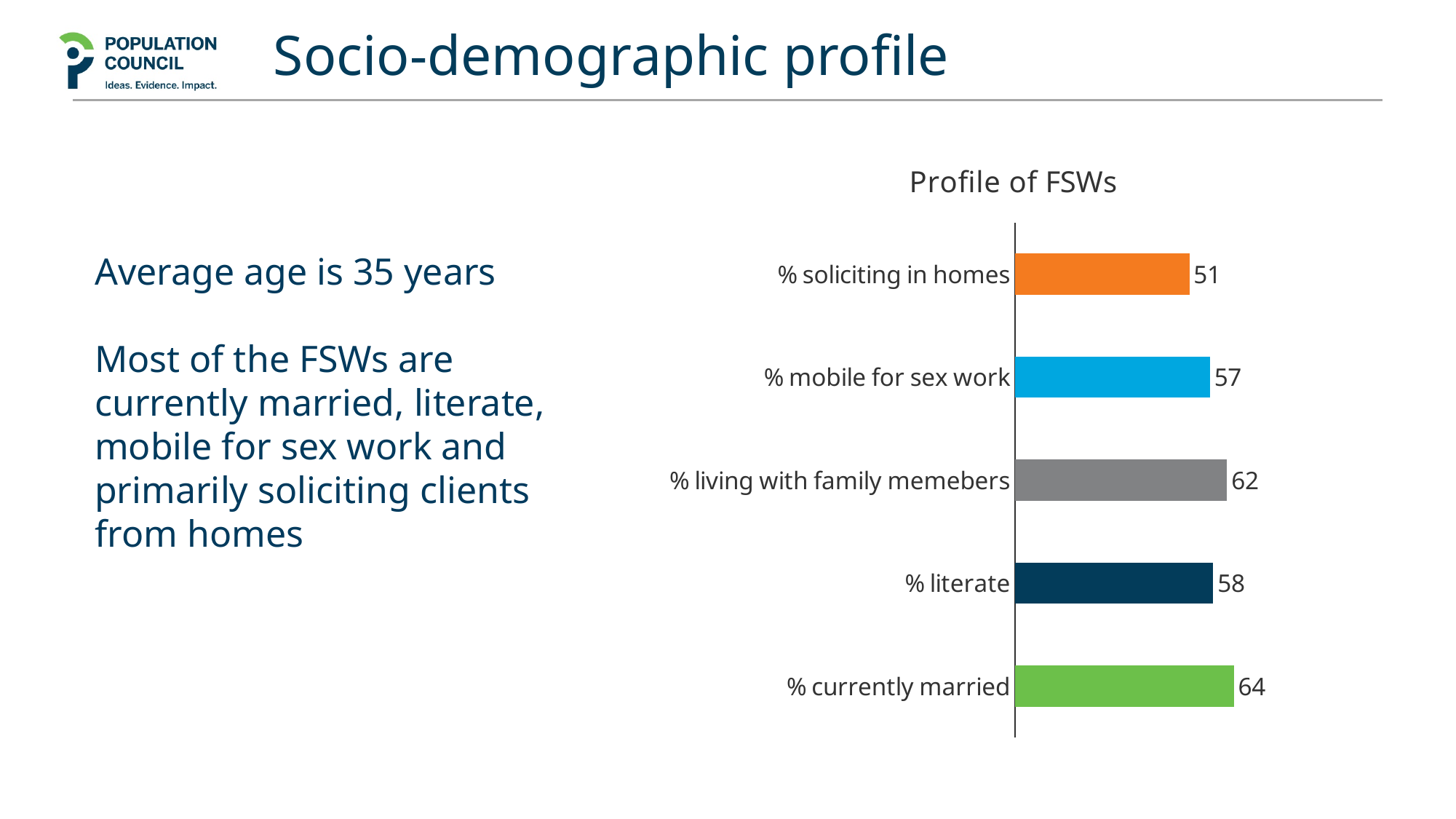
Which category has the lowest value? % soliciting in homes How many categories are shown in the chart? 5 What is the value for % living with family memebers? 62 What is the difference between the values for % currently married and % soliciting in homes? 13 Which category has the highest value? % currently married What is the value for % literate? 58 What kind of chart is shown on the slide? Bar chart What is the value for % mobile for sex work? 57 What is the title of the chart? Profile of FSWs What is the value for % soliciting in homes? 51 What is the value for % currently married? 64 Which is larger, the value for % literate or the value for % living with family memebers? % living with family memebers